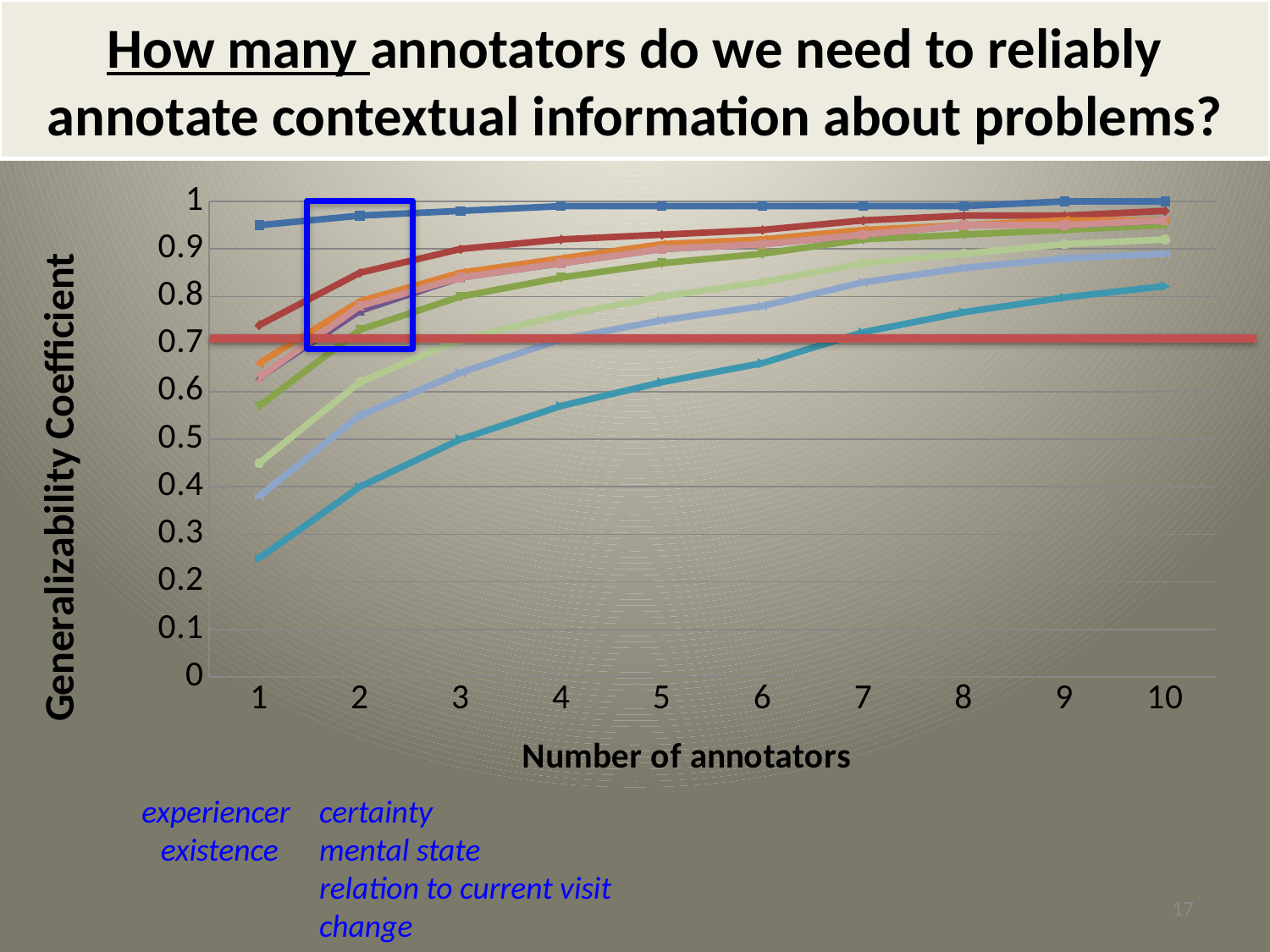
What is the maximum value shown on the y axis? 1 What is the label of the x axis? Number of annotators Is the value of the lowest line at 2 annotators greater or less than 0.5? less Do the plotted lines generally rise or fall as the number of annotators increases? rise Is the value of the lowest line at 10 annotators greater or less than 0.7? greater Is the value of the lowest line at 5 annotators greater or less than 0.7? less How many values of the number of annotators are shown along the x axis? 10 What kind of chart is shown on the slide? line chart What is the label of the y axis? Generalizability Coefficient